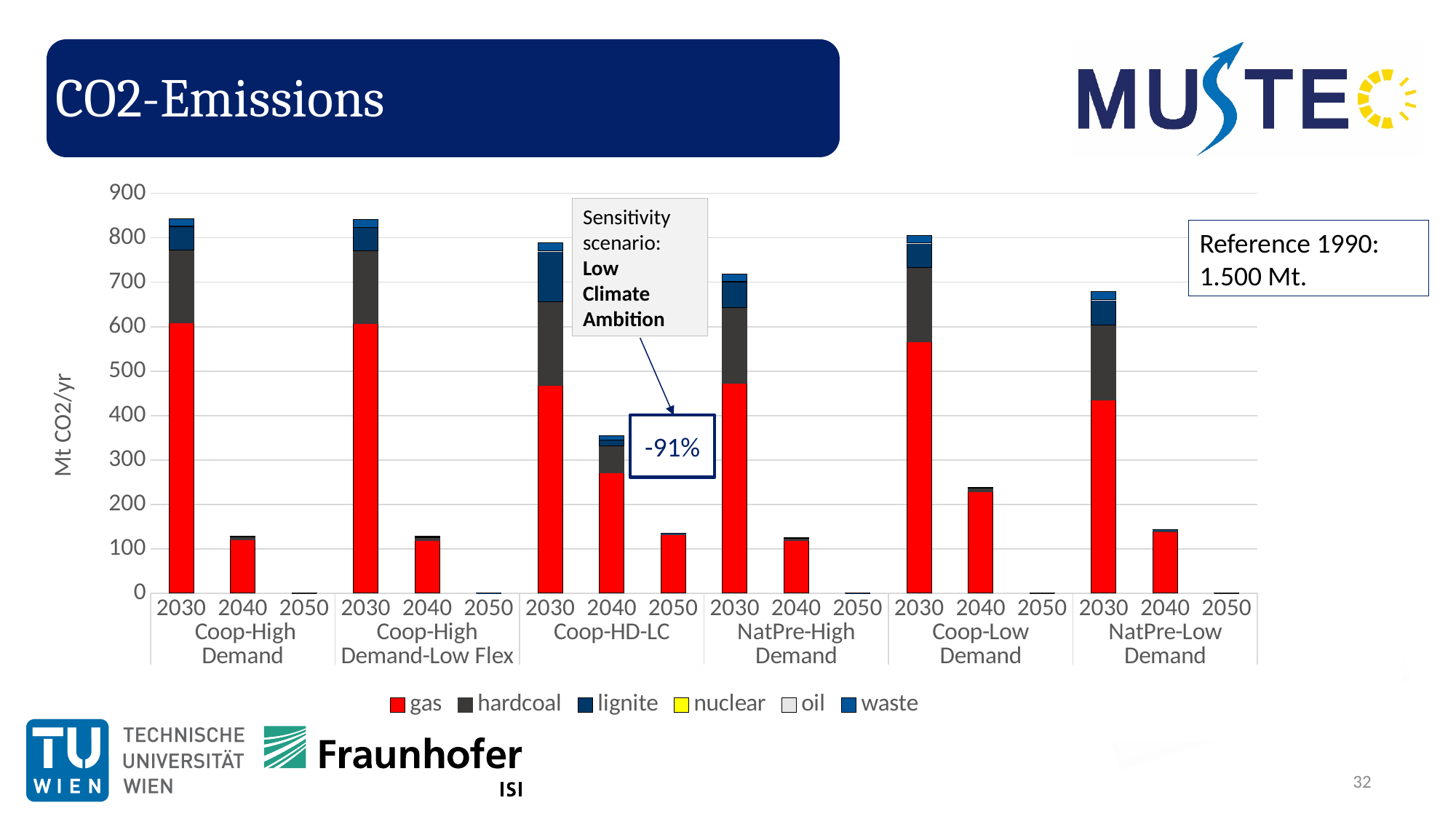
How many series does the legend list? 6 Is the total value for Coop-Low Demand in 2040 greater or less than 200? greater How many scenario groups are shown along the x axis? 6 What kind of chart is shown on the slide? stacked bar chart Which is larger in 2030: the total for Coop-Low Demand or the total for NatPre-High Demand? Coop-Low Demand Is the total value for Coop-HD-LC in 2040 greater or less than 300? greater Is the total value for NatPre-Low Demand in 2030 greater or less than 700? less What is the label of the y axis? Mt CO2/yr How many bars are plotted in the chart? 18 Within the Coop-High Demand scenario, do total emissions rise or fall from 2030 to 2050? fall Which scenario has the highest total emissions in 2040? Coop-HD-LC